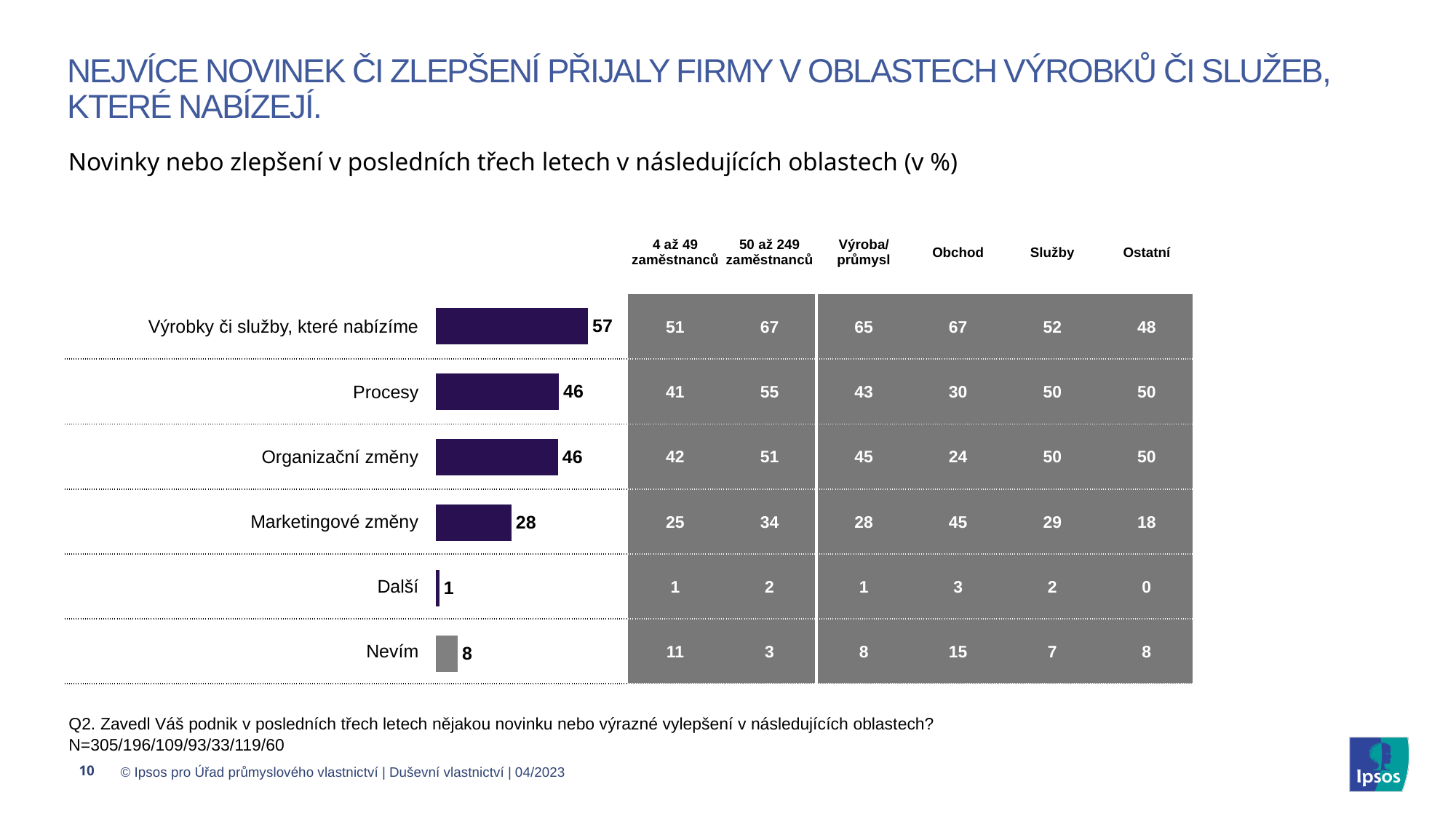
In the table, what is the value for "Procesy" in the "Obchod" column? 30 What kind of chart is shown on the slide? Bar chart What is the difference between the values for "Výrobky či služby, které nabízíme" and "Procesy"? 11 Which is larger: the value for "Marketingové změny" or the value for "Nevím"? Marketingové změny Do the values for "Procesy" and "Organizační změny" differ in the bar chart? No, both are 46 Which category has the highest value in the bar chart? Výrobky či služby, které nabízíme What is the value for "Nevím" in the bar chart? 8 Which category has the lowest value in the bar chart? Další What is the value for "Marketingové změny" in the bar chart? 28 What is the value for "Výrobky či služby, které nabízíme" in the bar chart? 57 How many categories are shown in the bar chart? 6 Which bar in the chart is coloured grey rather than dark purple? Nevím